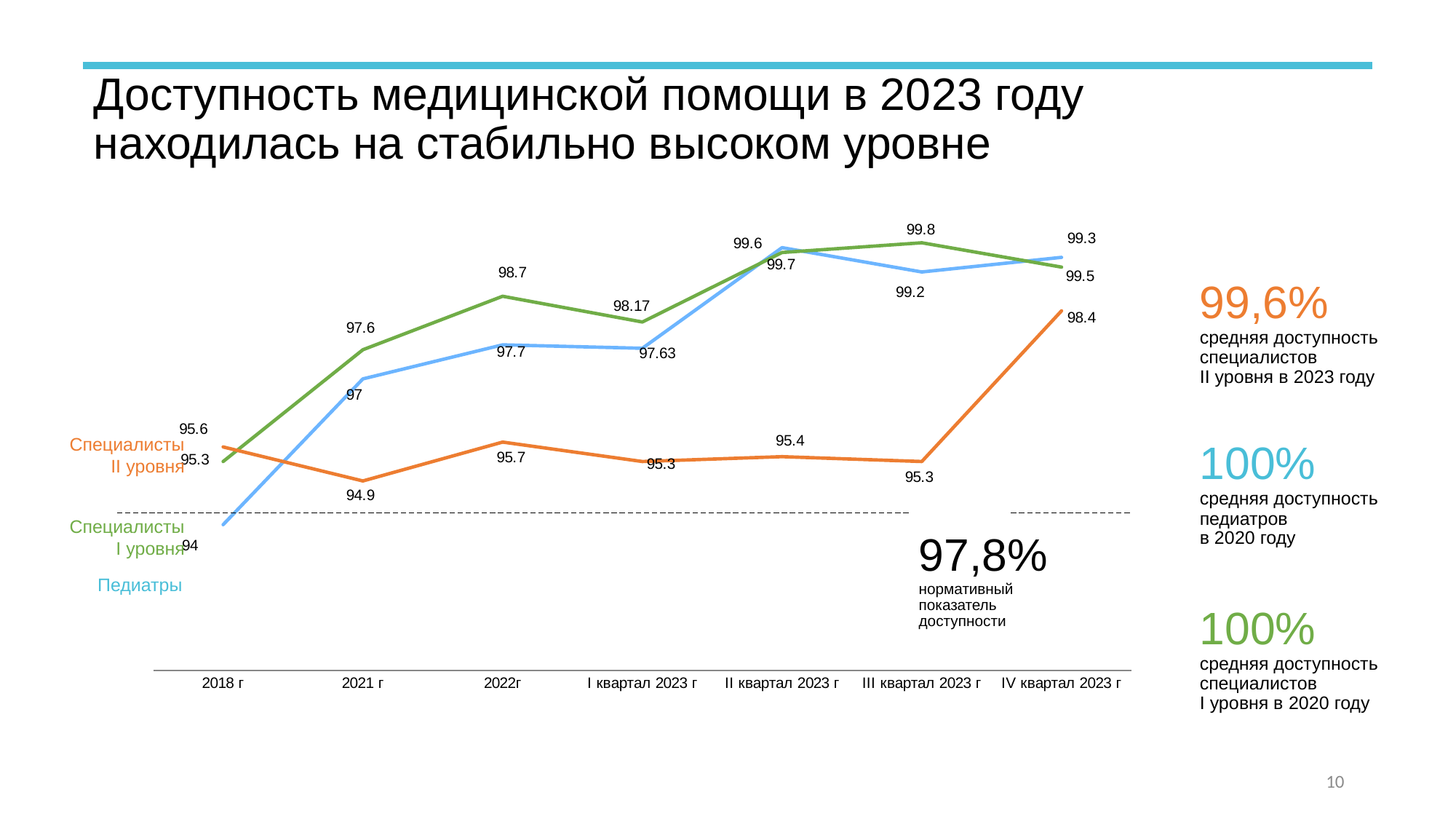
At which point on the x axis does Специалисты I уровня reach its highest value? III квартал 2023 г What is the value for Специалисты II уровня in IV квартал 2023 г? 98.4 In 2022г, which is higher: Специалисты I уровня or Педиатры? Специалисты I уровня How many series are plotted on the chart? 3 What is the difference between the Специалисты II уровня values for IV квартал 2023 г and III квартал 2023 г? 3.1 What is the value for Специалисты I уровня in III квартал 2023 г? 99.8 How many points are there along the x axis of the chart? 7 What kind of chart is shown on the slide? line chart At which point on the x axis does Специалисты II уровня have its lowest value? 2021 г What is the value for Педиатры in I квартал 2023 г? 97.63 Does the Педиатры line rise or fall from 2018 г to 2022г? rise What is the value for Педиатры in 2018 г? 94